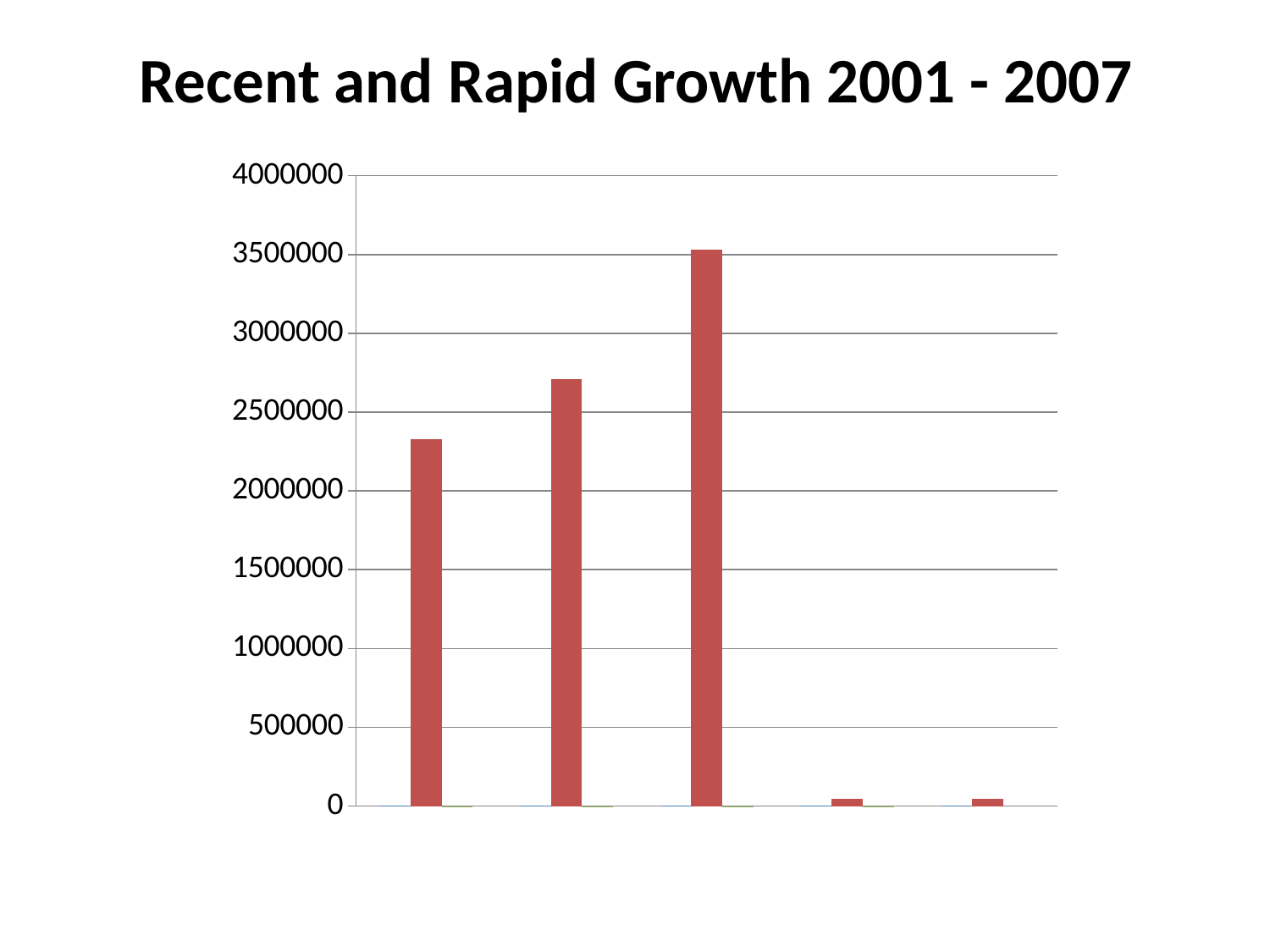
Is the value of the first bar from the left greater or less than 2000000? greater What kind of chart is shown on the slide? bar chart How many bars are plotted in the chart? 5 Which is larger, the first bar from the left or the second bar from the left? the second bar from the left What is the highest value shown on the vertical axis? 4000000 Is the value of the third bar from the left greater or less than 3000000? greater Which bar is the tallest in the chart? the third bar from the left Which is larger, the third bar from the left or the fifth bar from the left? the third bar from the left What is the title of the slide's chart? Recent and Rapid Growth 2001 - 2007 Is the value of the fourth bar from the left greater or less than 500000? less